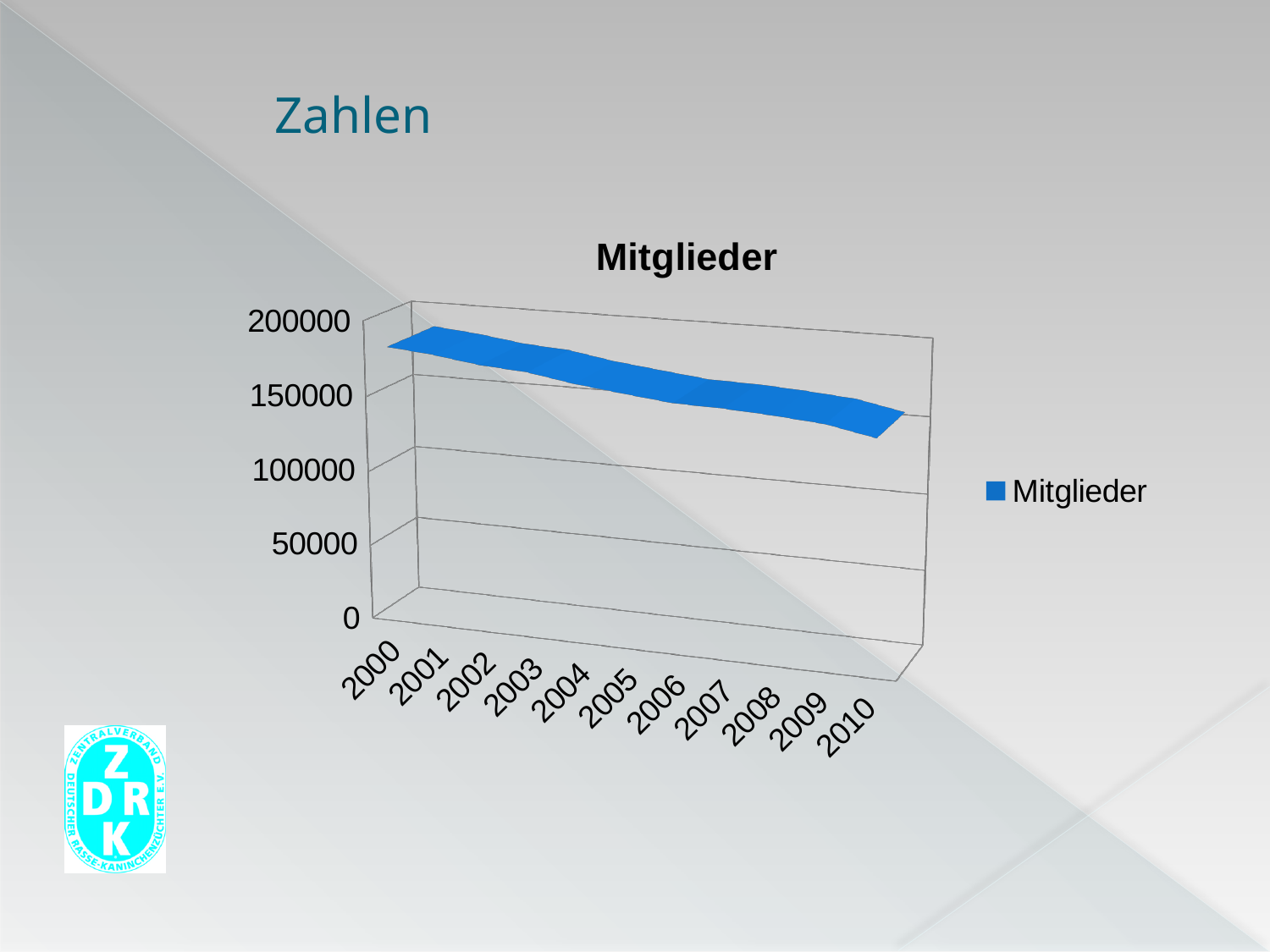
What kind of chart is shown on the slide? 3D line chart Is the Mitglieder value for 2010 greater or less than 200000? less Which year has the larger Mitglieder value, 2000 or 2010? 2000 Which year has the lowest Mitglieder value? 2010 What colour is the Mitglieder series in the chart? blue How many years are shown on the x axis of the chart? 11 How many series does the legend list? 1 Is the Mitglieder value for 2000 greater or less than 150000? greater What is the title of the chart? Mitglieder Which year has the highest Mitglieder value? 2000 Is the Mitglieder value for 2005 greater or less than 100000? greater Do the Mitglieder values rise or fall from 2000 to 2010? fall